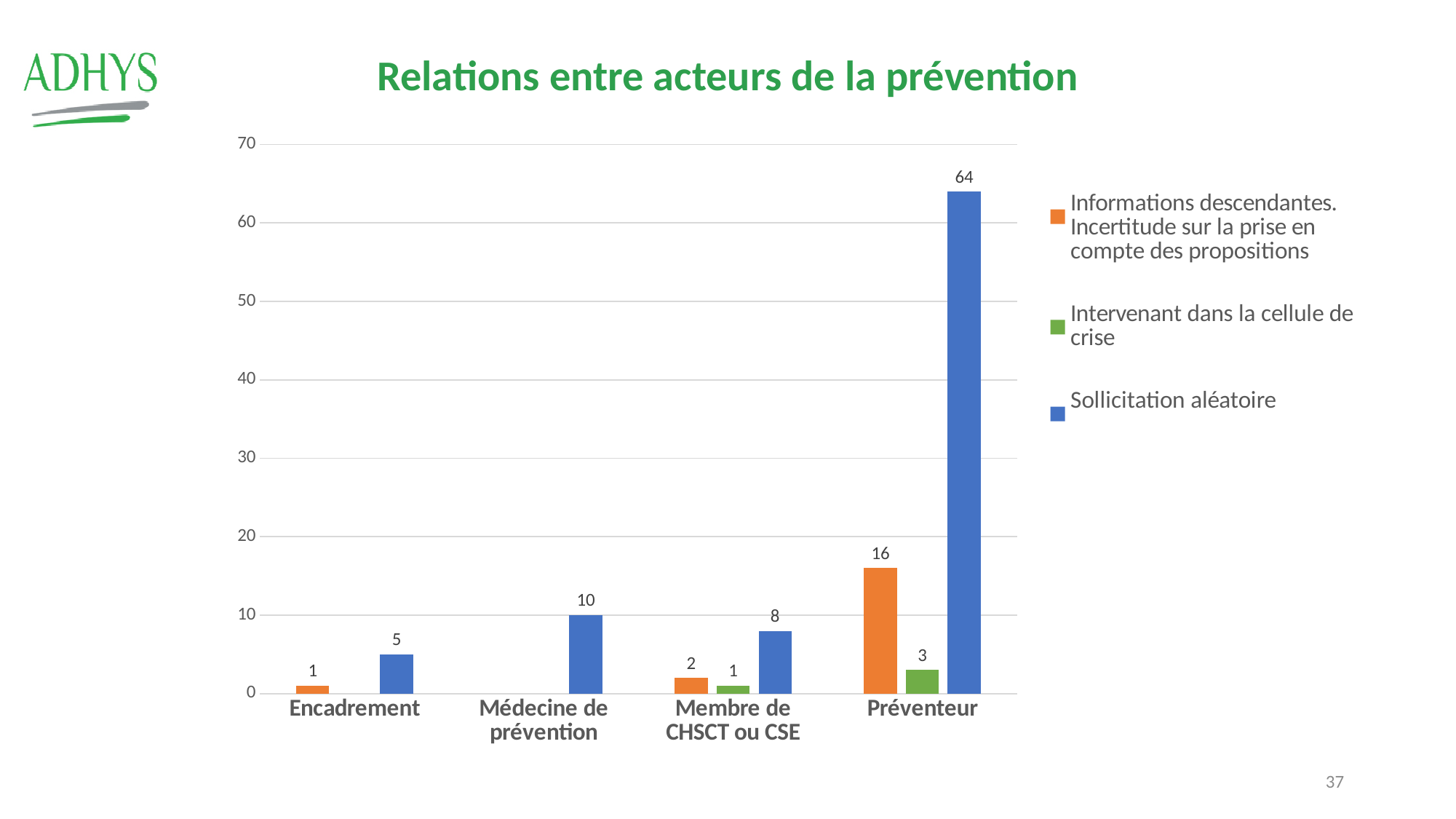
What is the title of the chart? Relations entre acteurs de la prévention What is the difference between the 'Sollicitation aléatoire' value and the 'Informations descendantes' value for Préventeur? 48 What is the value of 'Sollicitation aléatoire' for Médecine de prévention? 10 Which is larger: 'Sollicitation aléatoire' for Médecine de prévention or for Membre de CHSCT ou CSE? Médecine de prévention Which category has the lowest value for 'Sollicitation aléatoire'? Encadrement What is the value of 'Intervenant dans la cellule de crise' for Préventeur? 3 What kind of chart is shown on the slide? Bar chart How many categories are shown on the x axis? 4 How many series does the legend list? 3 Which category has the highest value for 'Sollicitation aléatoire'? Préventeur What is the value of 'Sollicitation aléatoire' for Préventeur? 64 What is the value of 'Informations descendantes. Incertitude sur la prise en compte des propositions' for Membre de CHSCT ou CSE? 2